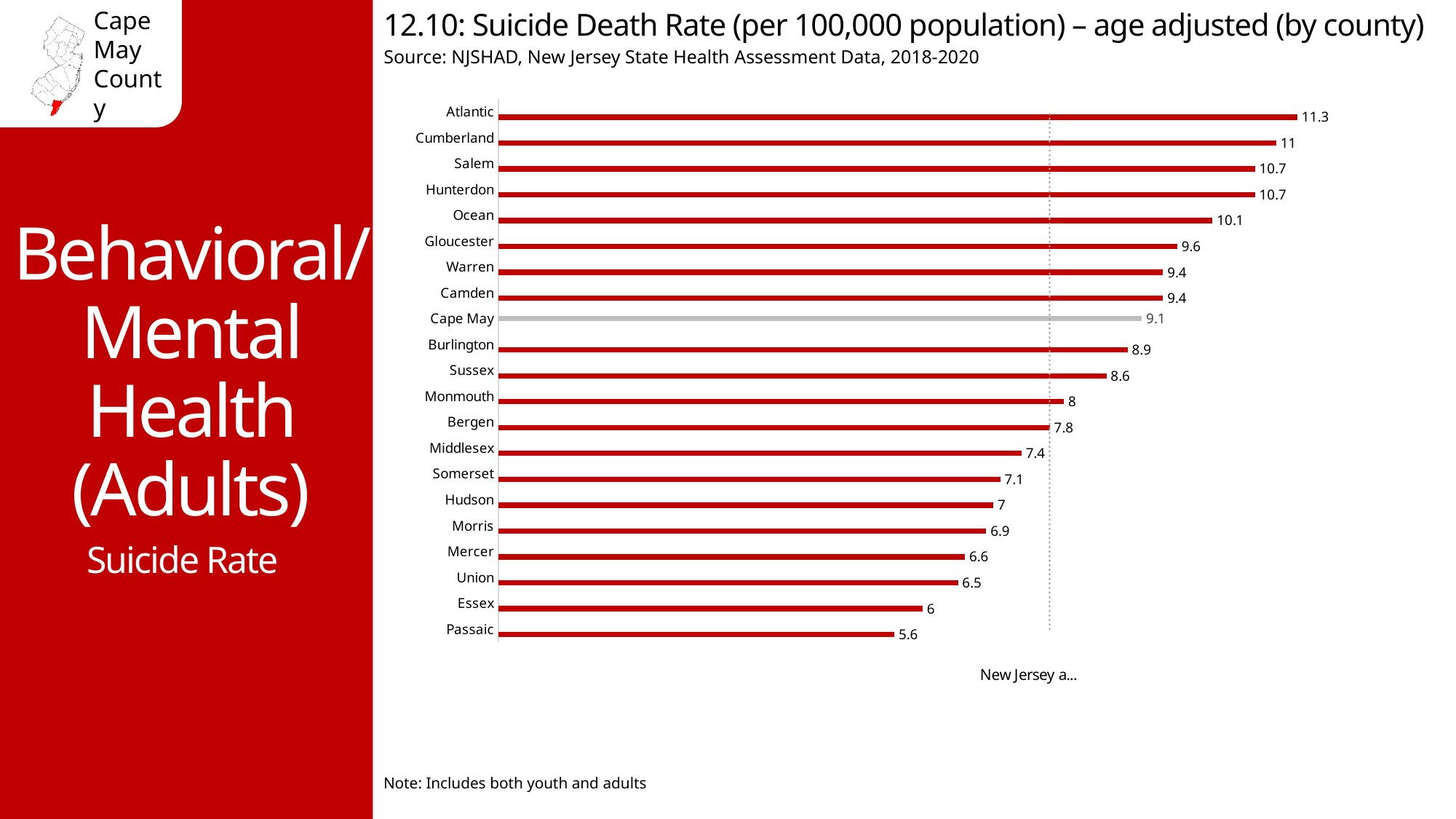
Which county has the highest suicide death rate? Atlantic Which county's bar is shown in grey rather than red? Cape May What is the difference between the suicide death rates of Atlantic and Passaic? 5.7 Which county has the lowest suicide death rate? Passaic What is the suicide death rate for Passaic? 5.6 How many counties are shown in the chart? 21 What is the suicide death rate for Gloucester? 9.6 What is the suicide death rate for Cape May? 9.1 What is the difference between the suicide death rates of Cape May and Burlington? 0.2 What is the suicide death rate for Atlantic? 11.3 What type of chart is shown on the slide? Bar chart Which has a higher suicide death rate, Ocean or Bergen? Ocean